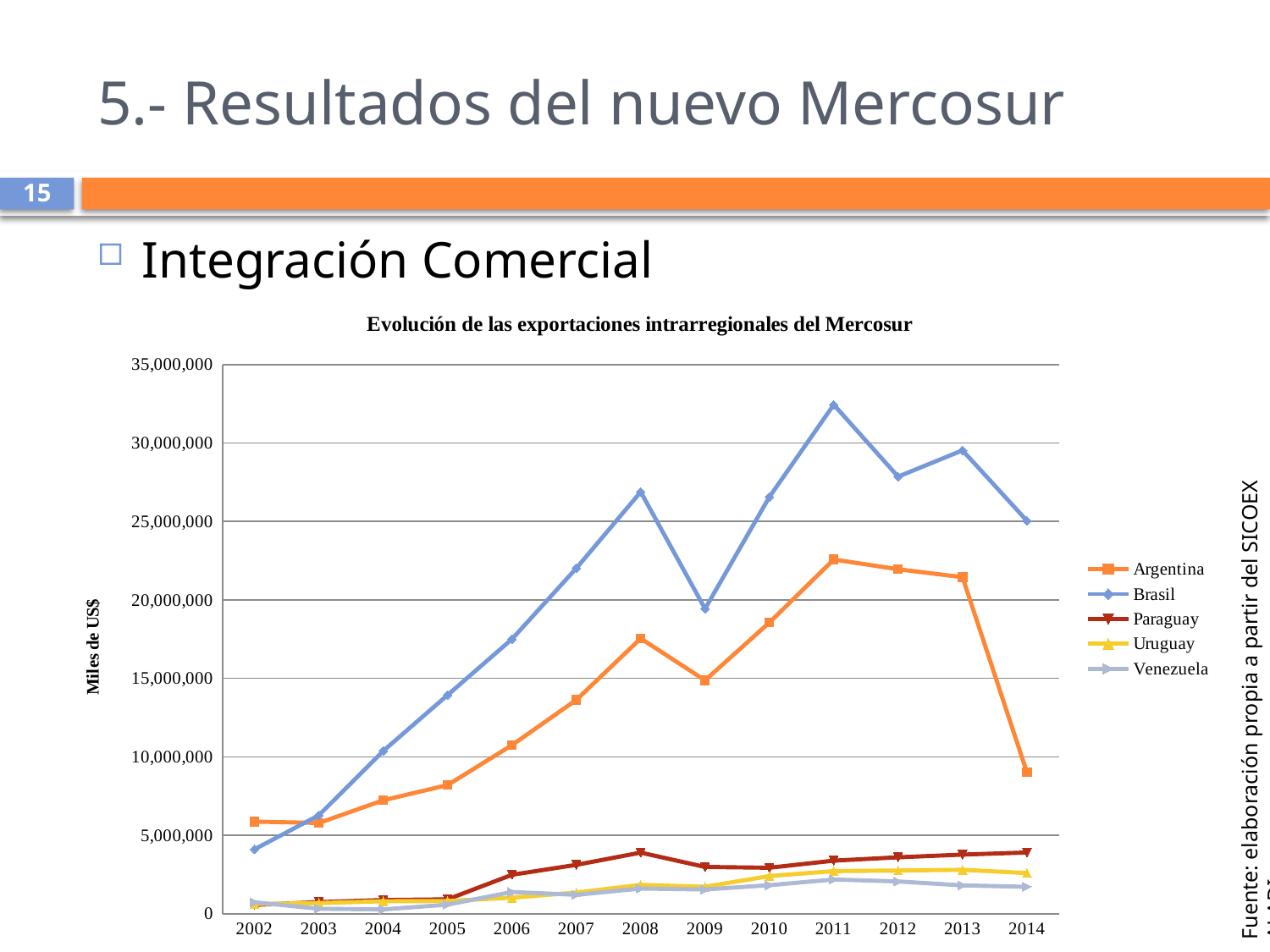
What is the title of the chart? Evolución de las exportaciones intrarregionales del Mercosur How many years are shown on the x axis? 13 How many series does the legend list? 5 Which is larger in 2014, Paraguay or Uruguay? Paraguay Is the value for Brasil in 2011 greater or less than 30,000,000? greater Which series has the lowest value in 2014? Venezuela Does the Argentina series rise or fall from 2013 to 2014? fall Which series reaches the highest value on the chart? Brasil Is the value for Paraguay in 2014 greater or less than 5,000,000? less In which year does the Brasil series reach its peak? 2011 Is the value for Argentina in 2014 greater or less than 10,000,000? less What kind of chart is shown on the slide? line chart